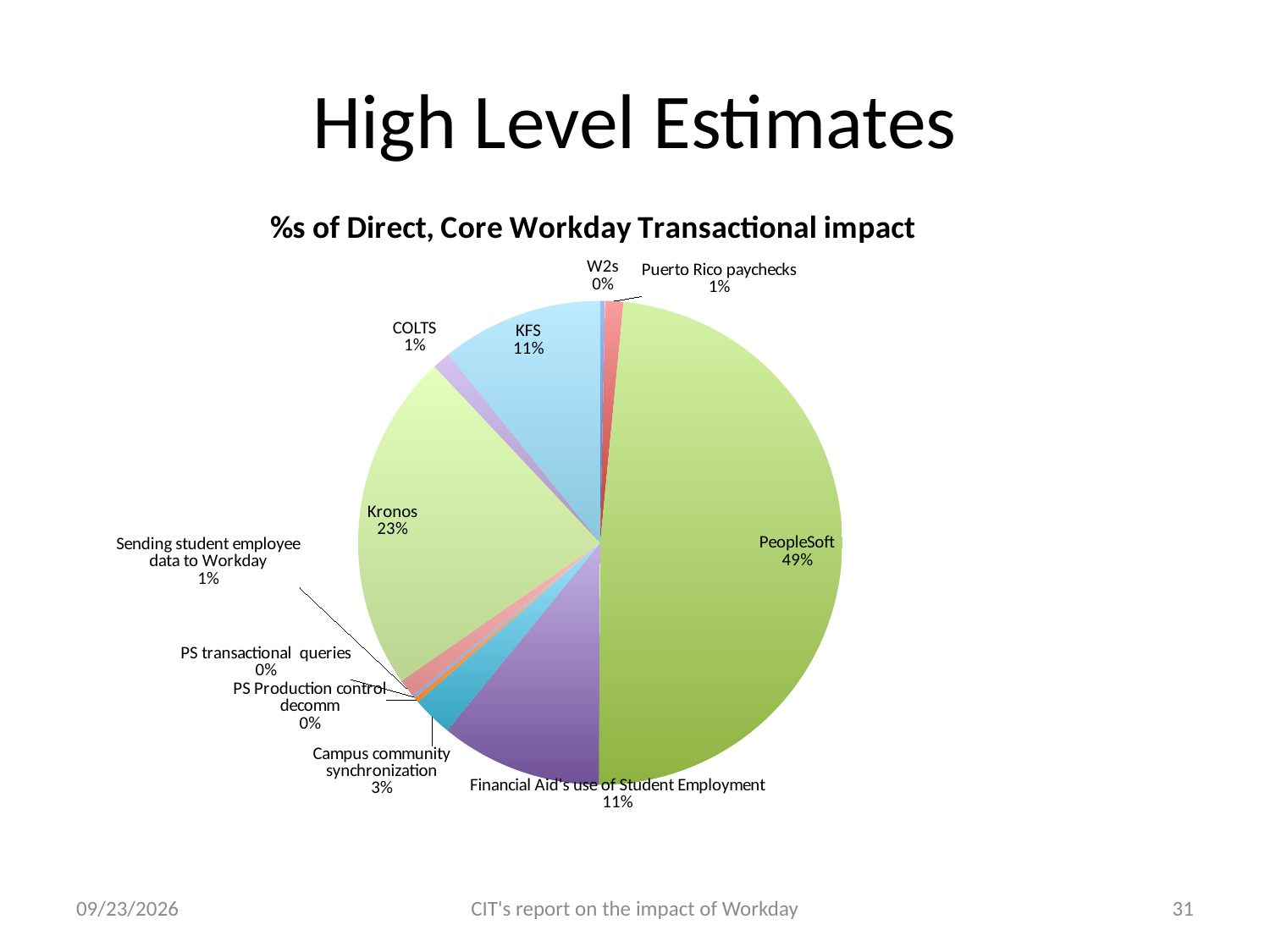
What share of the pie does PeopleSoft represent? 49% What percentage is shown for Kronos? 23% What percentage is shown for COLTS? 1% What percentage is shown for Financial Aid's use of Student Employment? 11% What percentage is shown for KFS? 11% What is the difference in percentage points between PeopleSoft and Kronos? 26 Which is larger, the share for Kronos or the share for KFS? Kronos What is the title of the chart? %s of Direct, Core Workday Transactional impact What type of chart is shown on the slide? pie chart Which category has the largest slice of the pie? PeopleSoft How many categories are shown in the pie chart? 11 What percentage is shown for Campus community synchronization? 3%